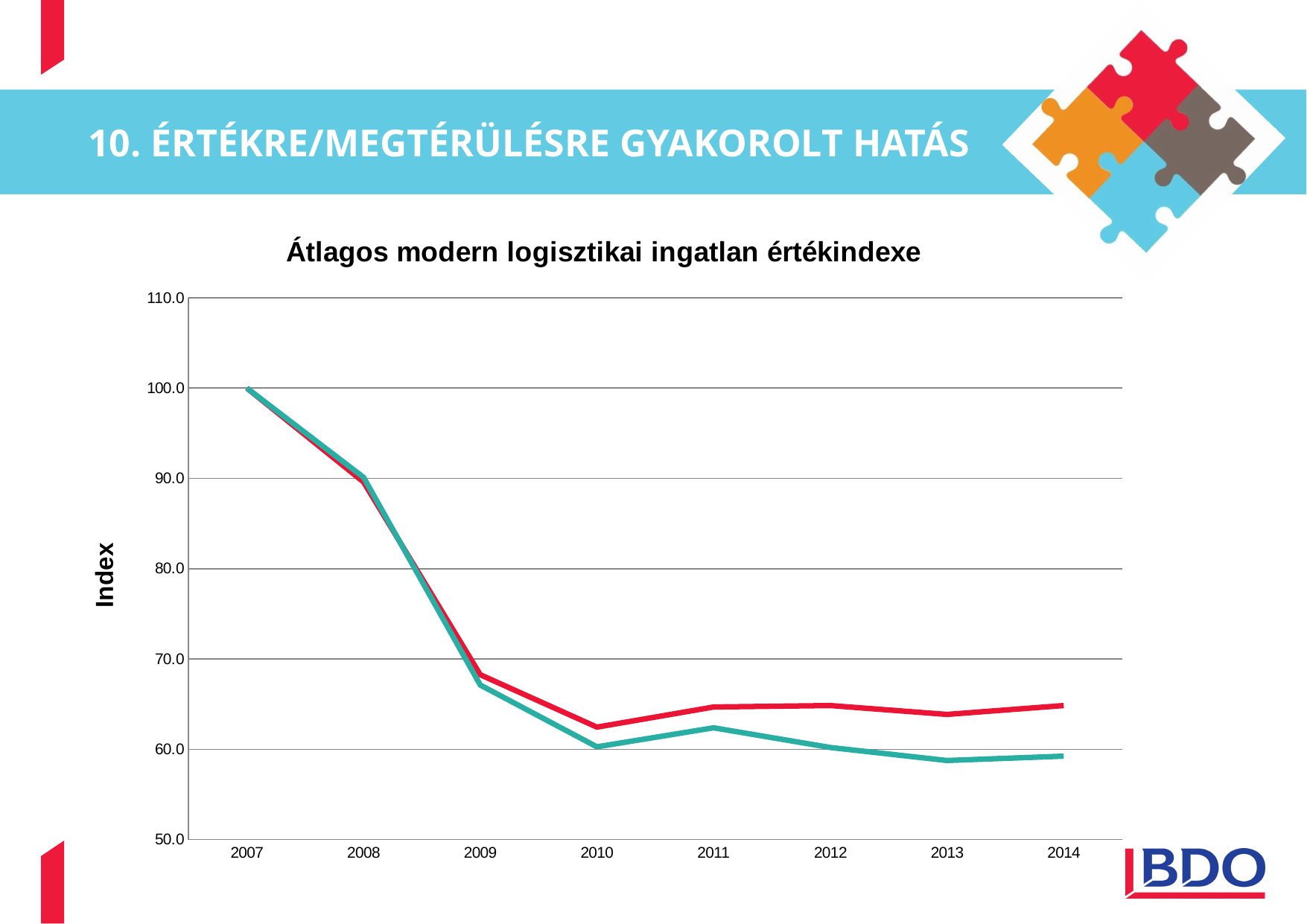
Is the value of the teal line in 2013 greater or less than 60.0? less How many lines are plotted on the chart? 2 What kind of chart is shown on the slide? line chart In which year does the red line reach its highest value? 2007 What is the value of the red line in 2007? 100.0 What is the title of the chart? Átlagos modern logisztikai ingatlan értékindexe Is the value of the red line in 2014 greater or less than 60.0? greater Is the value of the red line in 2009 greater or less than 70.0? less In 2014, which line has the higher value, the red line or the teal line? the red line How many years are shown on the x axis of the chart? 8 What is the label on the vertical axis of the chart? Index In which year does the red line reach its lowest value? 2010